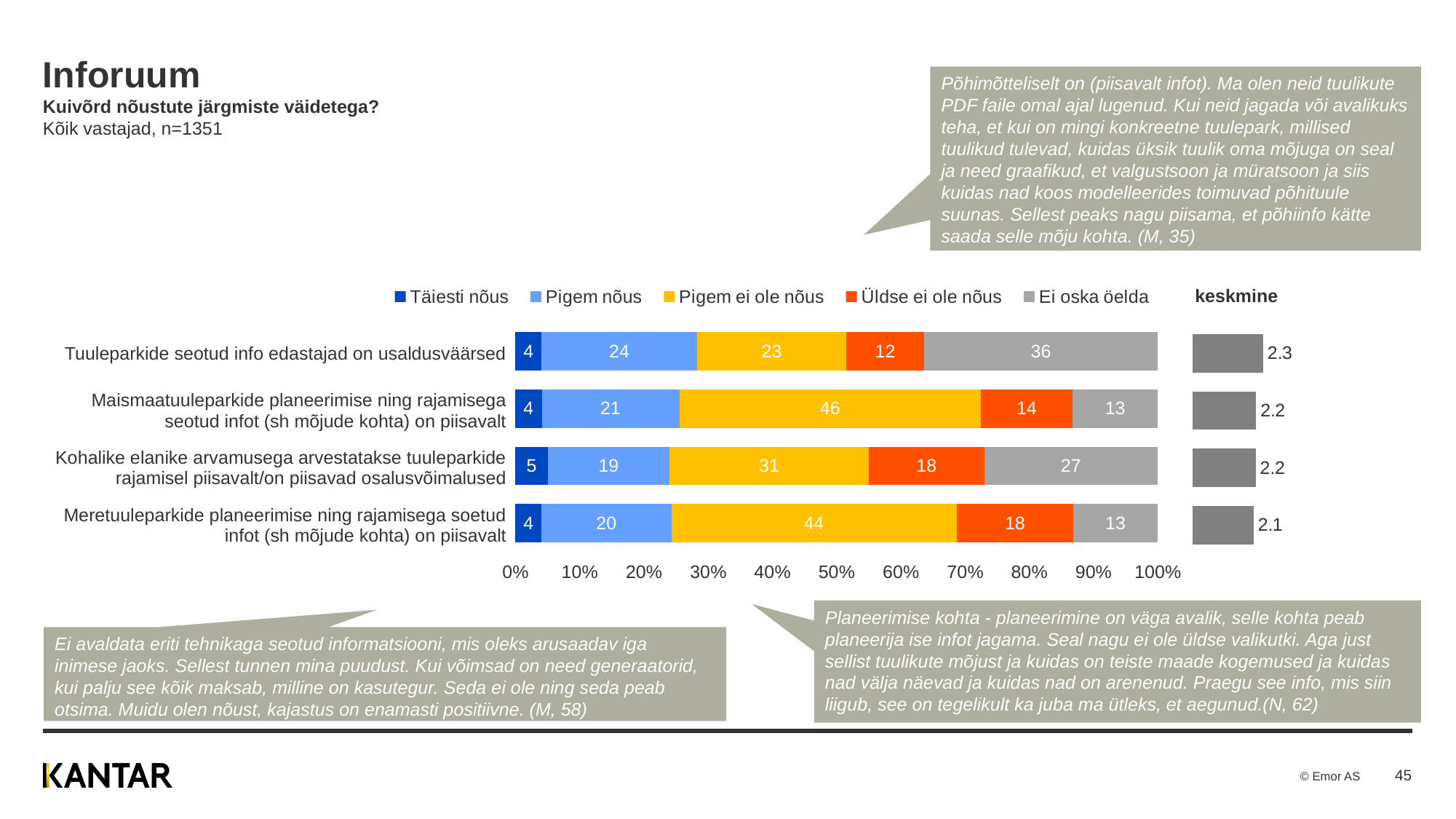
Which has the larger 'Pigem nõus' value: 'Tuuleparkide seotud info edastajad on usaldusväärsed' or 'Meretuuleparkide planeerimise ning rajamisega soetud infot (sh mõjude kohta) on piisavalt'? Tuuleparkide seotud info edastajad on usaldusväärsed What is the difference between the 'Üldse ei ole nõus' values for 'Kohalike elanike arvamusega arvestatakse tuuleparkide rajamisel piisavalt/on piisavad osalusvõimalused' and 'Tuuleparkide seotud info edastajad on usaldusväärsed'? 6 What is the 'Pigem ei ole nõus' value for 'Maismaatuuleparkide planeerimise ning rajamisega seotud infot (sh mõjude kohta) on piisavalt'? 46 What kind of chart is shown on the slide? bar chart What is the 'keskmine' value for 'Meretuuleparkide planeerimise ning rajamisega soetud infot (sh mõjude kohta) on piisavalt'? 2.1 Which statement has the highest 'Täiesti nõus' value? Kohalike elanike arvamusega arvestatakse tuuleparkide rajamisel piisavalt/on piisavad osalusvõimalused Which statement has the highest 'Pigem ei ole nõus' value? Maismaatuuleparkide planeerimise ning rajamisega seotud infot (sh mõjude kohta) on piisavalt How many series does the legend of the chart list? 5 How many statements (categories) are plotted in the chart? 4 What is the 'Ei oska öelda' value for 'Tuuleparkide seotud info edastajad on usaldusväärsed'? 36 Which statement has the highest 'keskmine' value? Tuuleparkide seotud info edastajad on usaldusväärsed What is the label above the column of values shown to the right of the stacked bars? keskmine